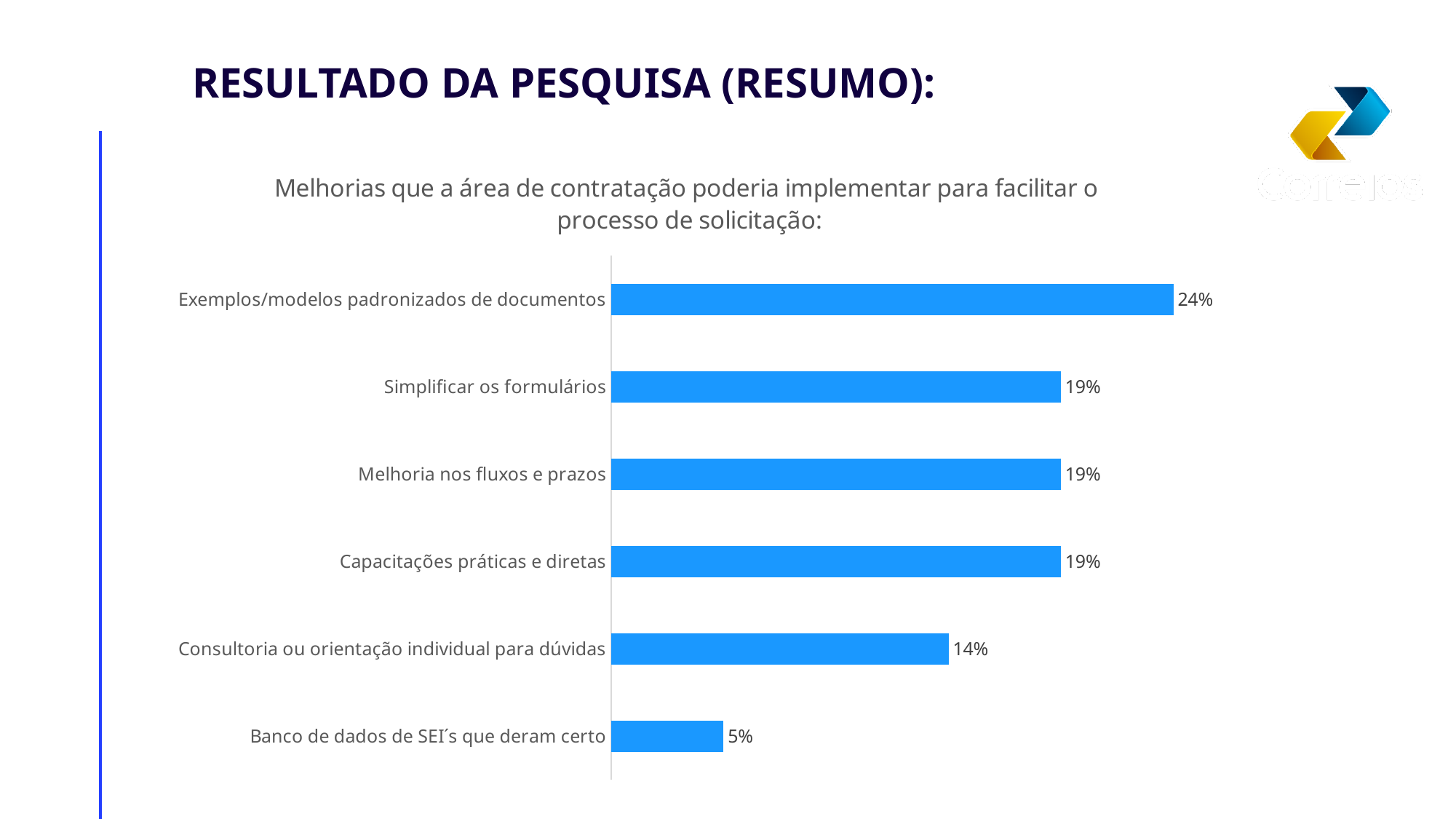
Which is larger: the value for "Capacitações práticas e diretas" or the value for "Consultoria ou orientação individual para dúvidas"? Capacitações práticas e diretas What is the title of the chart? Melhorias que a área de contratação poderia implementar para facilitar o processo de solicitação: What is the value for "Consultoria ou orientação individual para dúvidas"? 14% What is the value for "Banco de dados de SEI´s que deram certo"? 5% What is the value for "Exemplos/modelos padronizados de documentos"? 24% Which category has the lowest value? Banco de dados de SEI´s que deram certo What is the value for "Simplificar os formulários"? 19% What is the difference between the values for "Exemplos/modelos padronizados de documentos" and "Consultoria ou orientação individual para dúvidas"? 10% Which category has the highest value? Exemplos/modelos padronizados de documentos How many categories are shown in the chart? 6 What kind of chart is shown on the slide? Bar chart What is the difference between the values for "Simplificar os formulários" and "Banco de dados de SEI´s que deram certo"? 14%